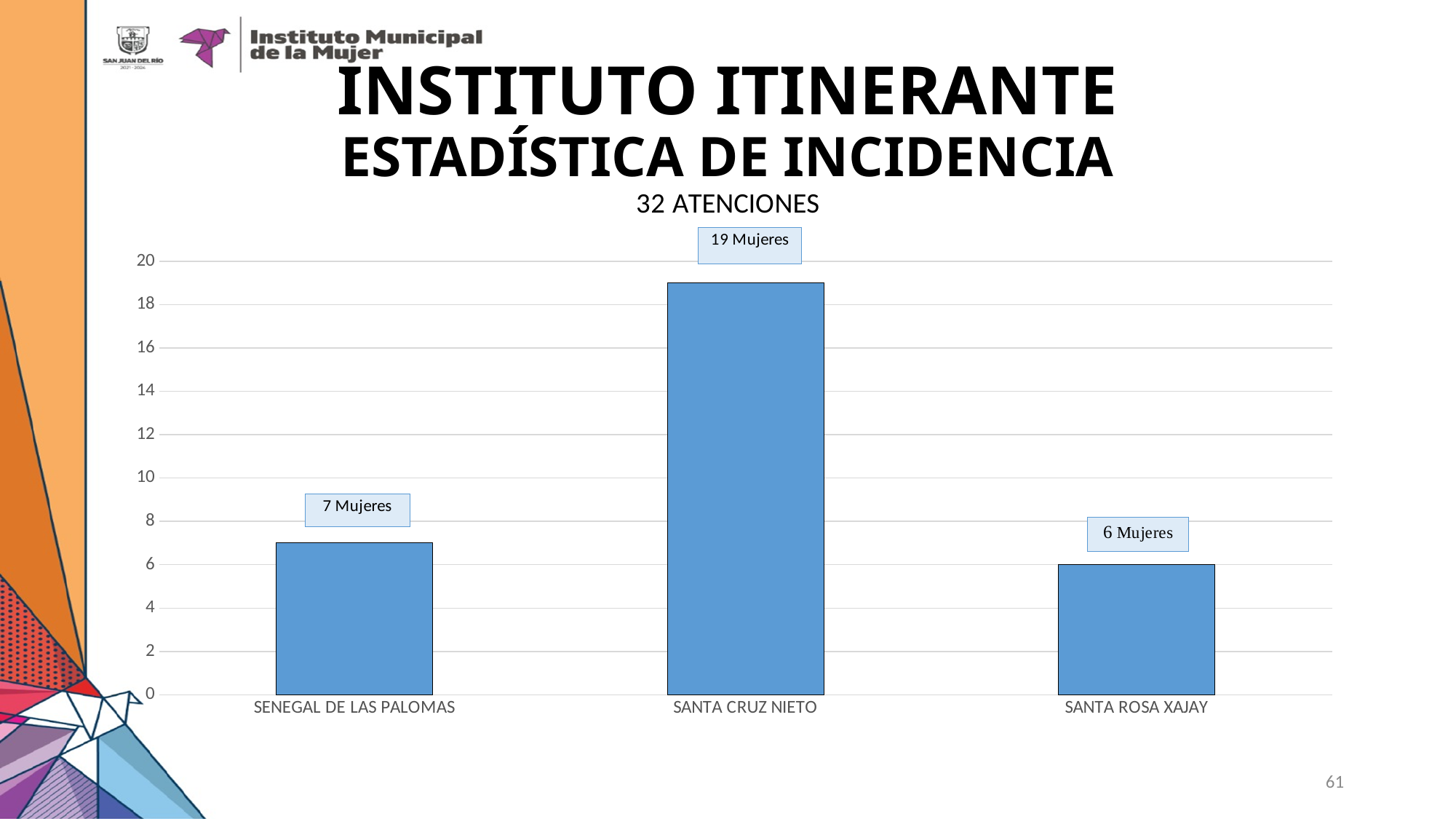
How many categories are shown on the x axis? 3 What is the value shown for SENEGAL DE LAS PALOMAS? 7 Mujeres Which category has the highest value? SANTA CRUZ NIETO What is the value shown for SANTA ROSA XAJAY? 6 Mujeres What is the difference between the values for SANTA CRUZ NIETO and SENEGAL DE LAS PALOMAS? 12 What kind of chart is shown on the slide? bar chart What is the value shown for SANTA CRUZ NIETO? 19 Mujeres What is the chart's title? 32 ATENCIONES Is the value for SANTA CRUZ NIETO greater or less than 10? greater Which is larger, the value for SANTA CRUZ NIETO or the value for SANTA ROSA XAJAY? SANTA CRUZ NIETO Which category has the lowest value? SANTA ROSA XAJAY What is the difference between the values for SENEGAL DE LAS PALOMAS and SANTA ROSA XAJAY? 1